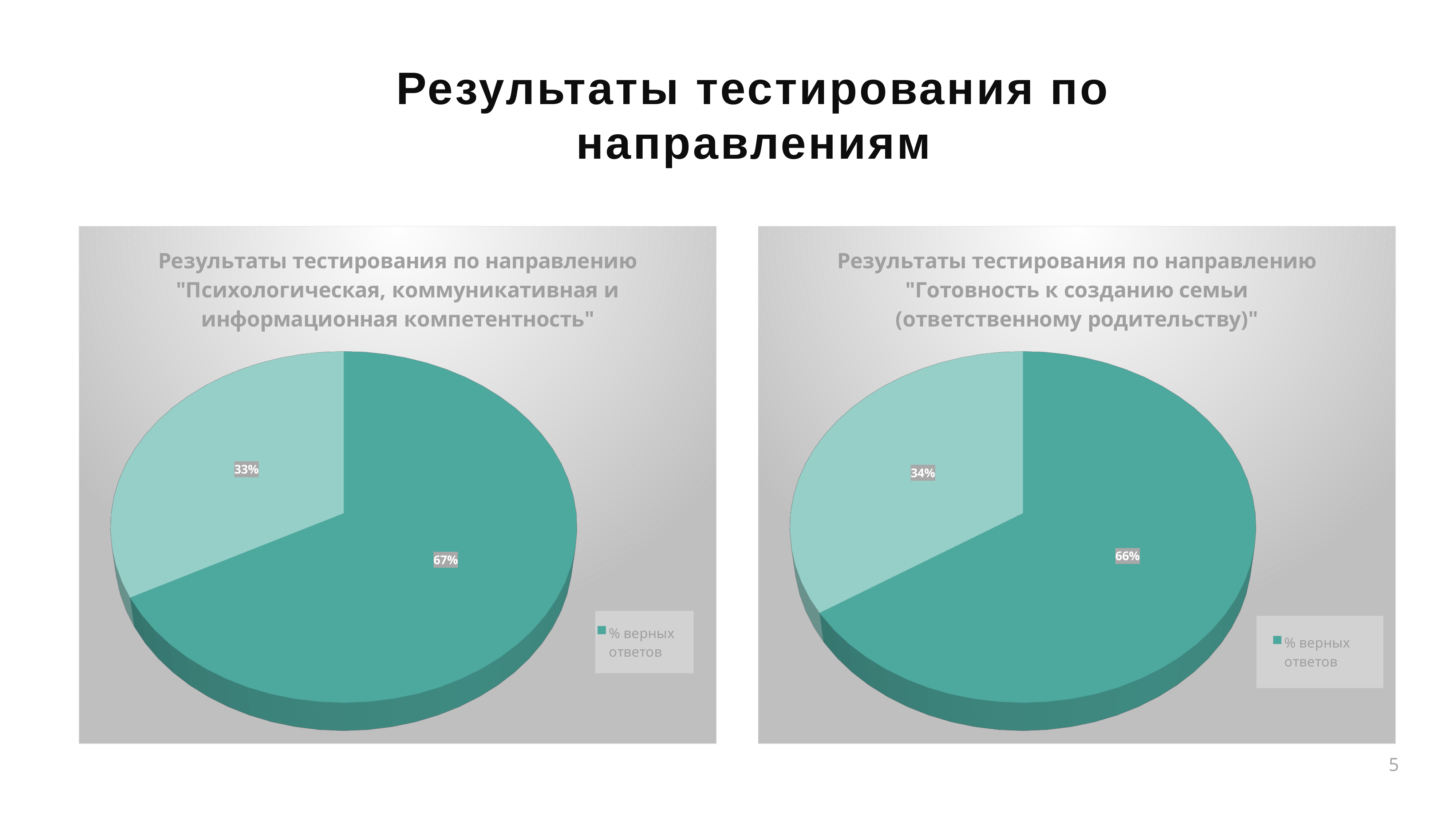
What kind of chart is the right chart, "Результаты тестирования по направлению "Готовность к созданию семьи (ответственному родительству)""? Pie chart What is the legend entry shown in the right chart ("Готовность к созданию семьи (ответственному родительству)")? % верных ответов What kind of chart is the left chart, "Результаты тестирования по направлению "Психологическая, коммуникативная и информационная компетентность""? Pie chart In the right chart ("Готовность к созданию семьи (ответственному родительству)"), what share does the larger slice have? 66% In the left chart ("Психологическая, коммуникативная и информационная компетентность"), what is the difference between the two slices' shares? 34% How many slices does the left pie chart ("Психологическая, коммуникативная и информационная компетентность") have? 2 In the right chart ("Готовность к созданию семьи (ответственному родительству)"), what share does the smaller slice have? 34% In the left chart ("Психологическая, коммуникативная и информационная компетентность"), what share does the larger slice have? 67% In the right chart ("Готовность к созданию семьи (ответственному родительству)"), what is the difference between the two slices' shares? 32% How many slices does the right pie chart ("Готовность к созданию семьи (ответственному родительству)") have? 2 How many entries does the legend of the left chart ("Психологическая, коммуникативная и информационная компетентность") list? 1